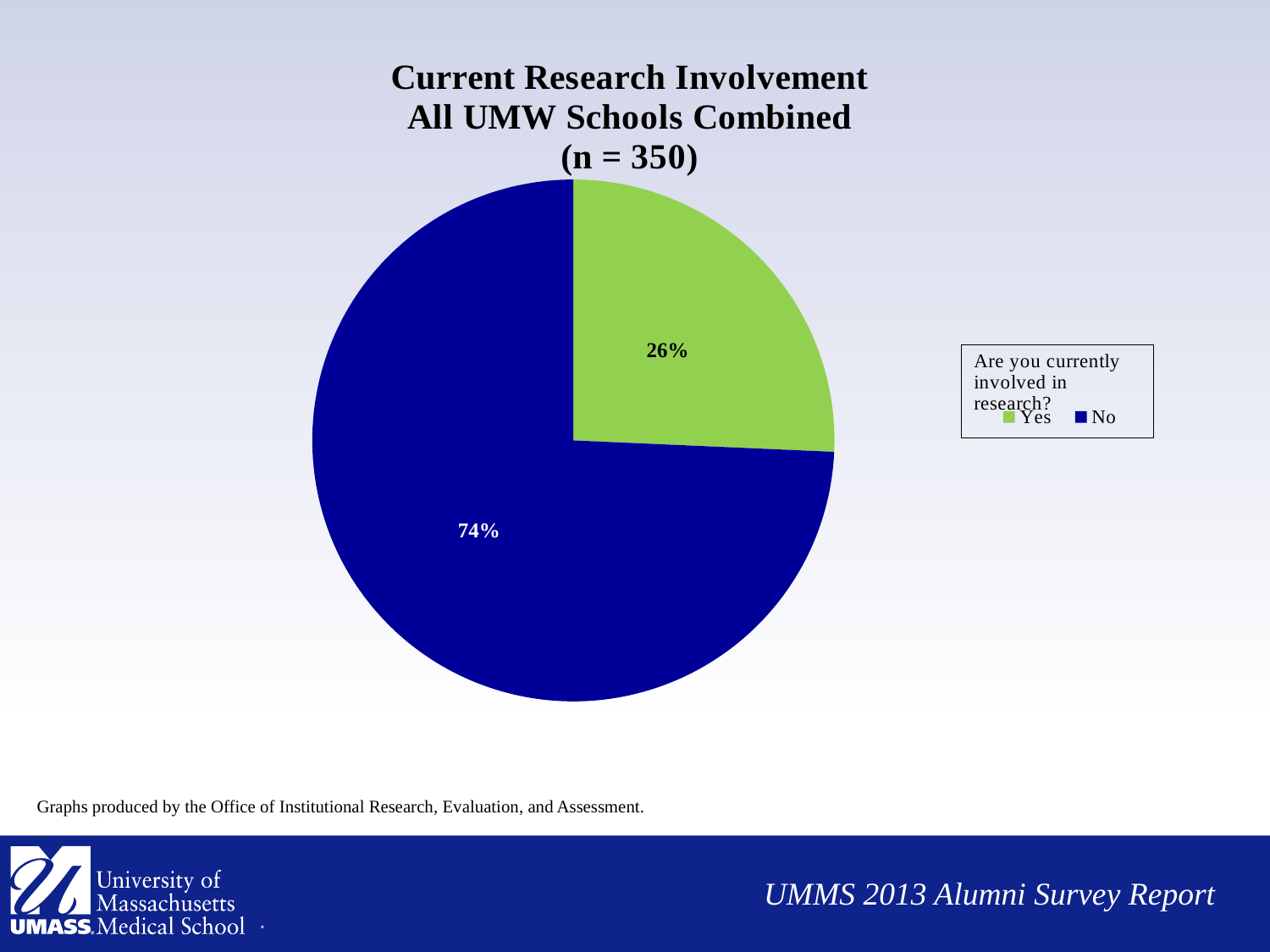
Which slice is larger, "Yes" or "No"? No What kind of chart is shown on the slide? pie chart How many slices does the pie chart have? 2 What percentage of respondents answered "No" to being currently involved in research? 74% What percentage of respondents answered "Yes" to being currently involved in research? 26% What is the difference in percentage points between the "No" and "Yes" slices? 48 Which response has the smallest share of the pie? Yes What is the sample size (n) stated in the chart title? 350 What colour is the "Yes" slice? green How many entries does the legend list? 2 Which response has the largest share of the pie? No